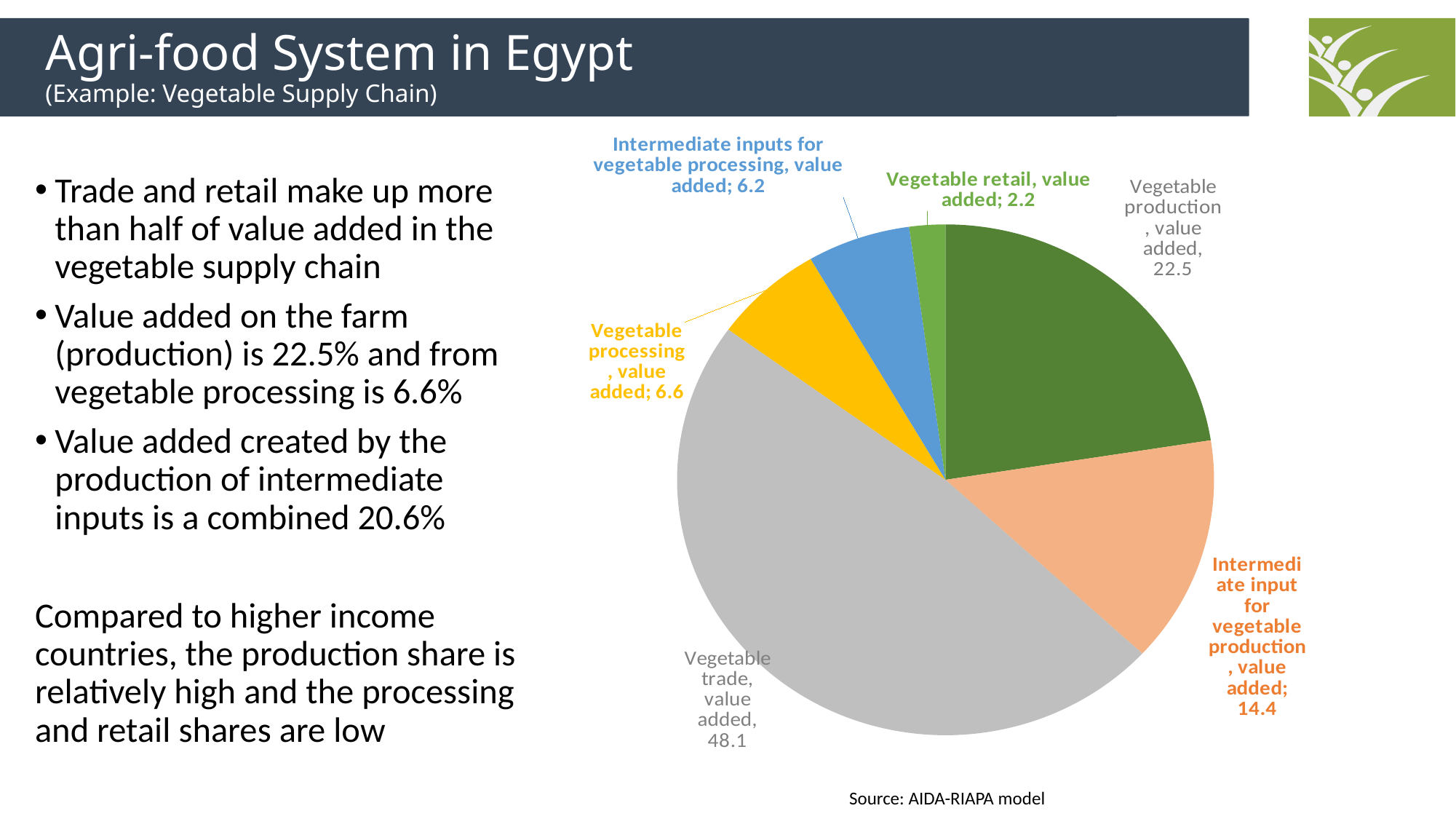
How many slices does the pie chart have? 6 What is the difference between the value added for vegetable production and for intermediate input for vegetable production? 8.1 What is the value added for vegetable production? 22.5 What is the value added for vegetable trade? 48.1 Which slice of the pie chart is the largest? Vegetable trade, value added Which slice of the pie chart is the smallest? Vegetable retail, value added What is the value added for intermediate input for vegetable production? 14.4 What colour is the vegetable trade slice in the pie chart? Grey What is the value added for vegetable retail? 2.2 Which is larger, the value added for vegetable processing or for intermediate inputs for vegetable processing? Vegetable processing, value added What kind of chart is shown on the slide? Pie chart What is the combined value added for vegetable processing and intermediate inputs for vegetable processing? 12.8